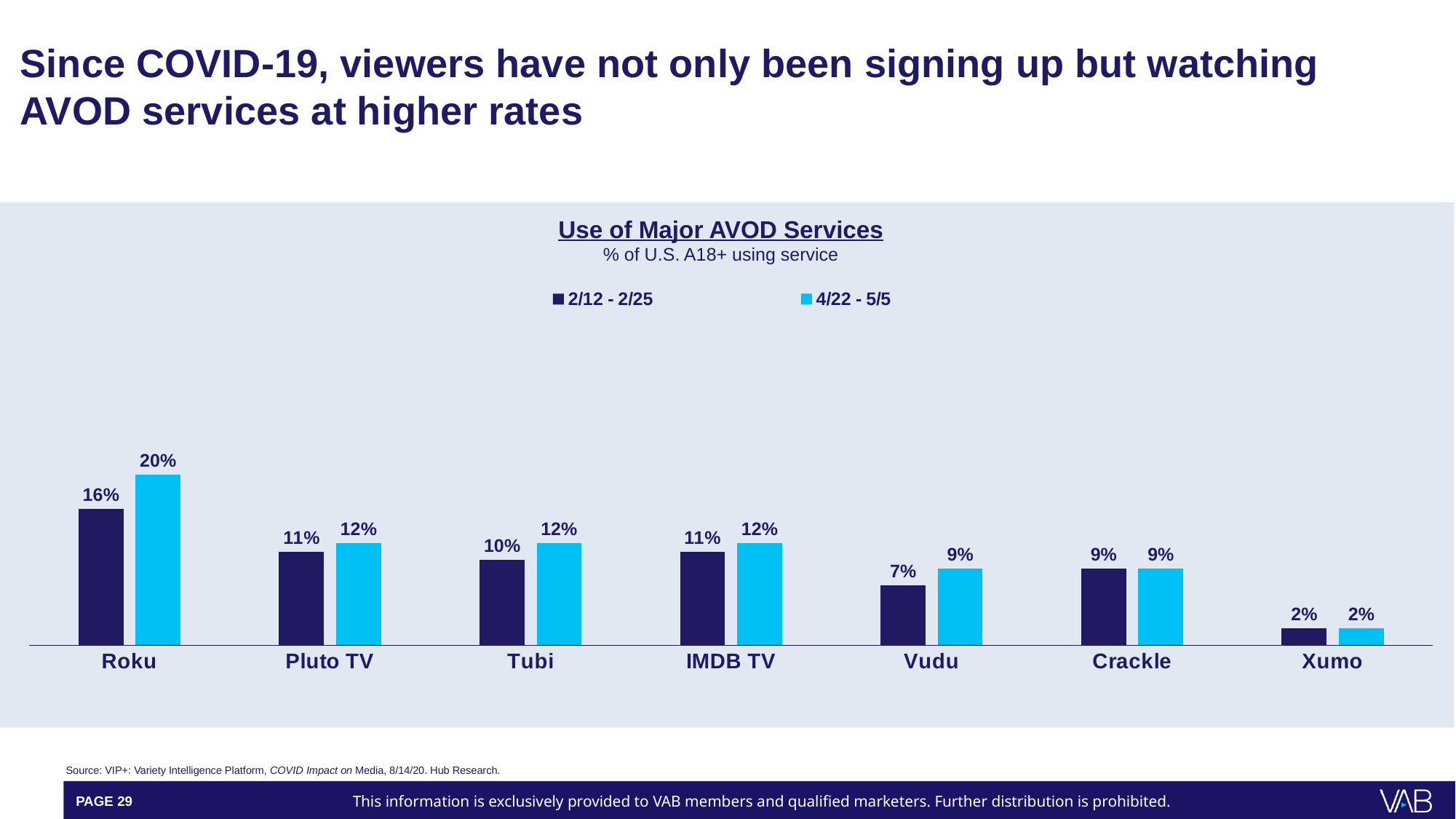
What is the title of the chart? Use of Major AVOD Services How many series does the legend list? 2 How many services are shown on the x axis? 7 Which is larger: Pluto TV's 4/22 - 5/5 value or Crackle's 4/22 - 5/5 value? Pluto TV What is the difference between Roku's 4/22 - 5/5 value and its 2/12 - 2/25 value? 4% What is the value for Tubi in the 2/12 - 2/25 series? 10% Which service has the lowest value in the 2/12 - 2/25 series? Xumo What kind of chart is shown on the slide? Bar chart What is the value for Roku in the 4/22 - 5/5 series? 20% What is the value for Vudu in the 2/12 - 2/25 series? 7% What is the difference between Vudu's 4/22 - 5/5 value and its 2/12 - 2/25 value? 2% Which service has the highest value in the 4/22 - 5/5 series? Roku